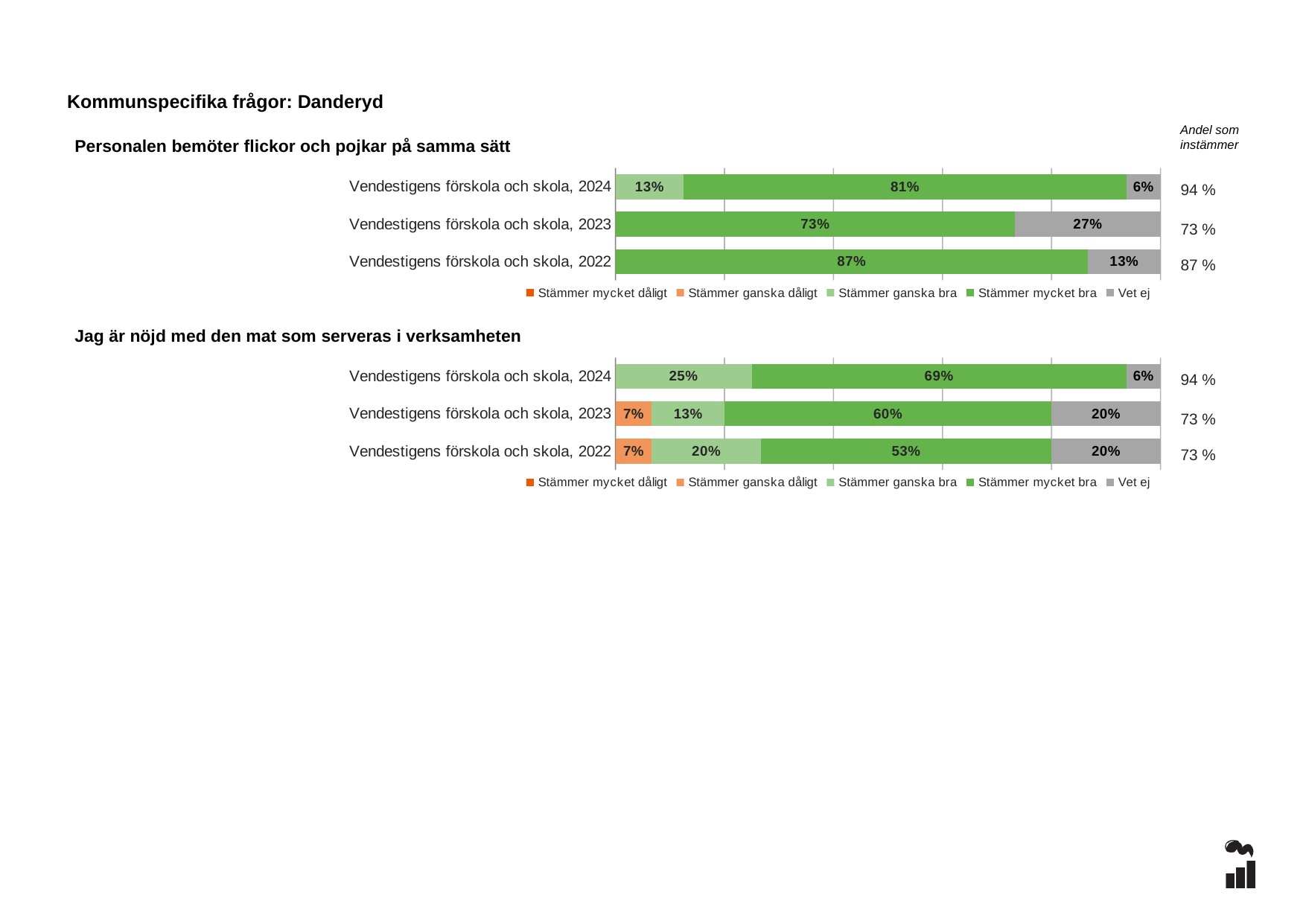
In the chart 'Personalen bemöter flickor och pojkar på samma sätt', which year has the highest 'Stämmer mycket bra' value? 2022 In the chart 'Jag är nöjd med den mat som serveras i verksamheten', is the 'Stämmer mycket bra' value for 2023 larger or smaller than for 2024? smaller In the chart 'Jag är nöjd med den mat som serveras i verksamheten', which year has the lowest 'Stämmer mycket bra' value? 2022 In the chart 'Personalen bemöter flickor och pojkar på samma sätt', what is the 'Vet ej' value for Vendestigens förskola och skola, 2023? 27% In the chart 'Jag är nöjd med den mat som serveras i verksamheten', what is the 'Stämmer ganska dåligt' value for 2022? 7% In the chart 'Personalen bemöter flickor och pojkar på samma sätt', what is the 'Stämmer mycket bra' value for Vendestigens förskola och skola, 2024? 81% How many series does the legend of the chart 'Jag är nöjd med den mat som serveras i verksamheten' list? 5 What kind of chart is 'Personalen bemöter flickor och pojkar på samma sätt'? Stacked bar chart In the chart 'Personalen bemöter flickor och pojkar på samma sätt', what is the difference between the 'Stämmer mycket bra' values for 2022 and 2023? 14 percentage points In the chart 'Jag är nöjd med den mat som serveras i verksamheten', what is the 'Andel som instämmer' for 2022? 73 % In the chart 'Jag är nöjd med den mat som serveras i verksamheten', what is the 'Stämmer ganska bra' value for Vendestigens förskola och skola, 2024? 25% In the chart 'Personalen bemöter flickor och pojkar på samma sätt', what is the 'Andel som instämmer' for 2024? 94 %